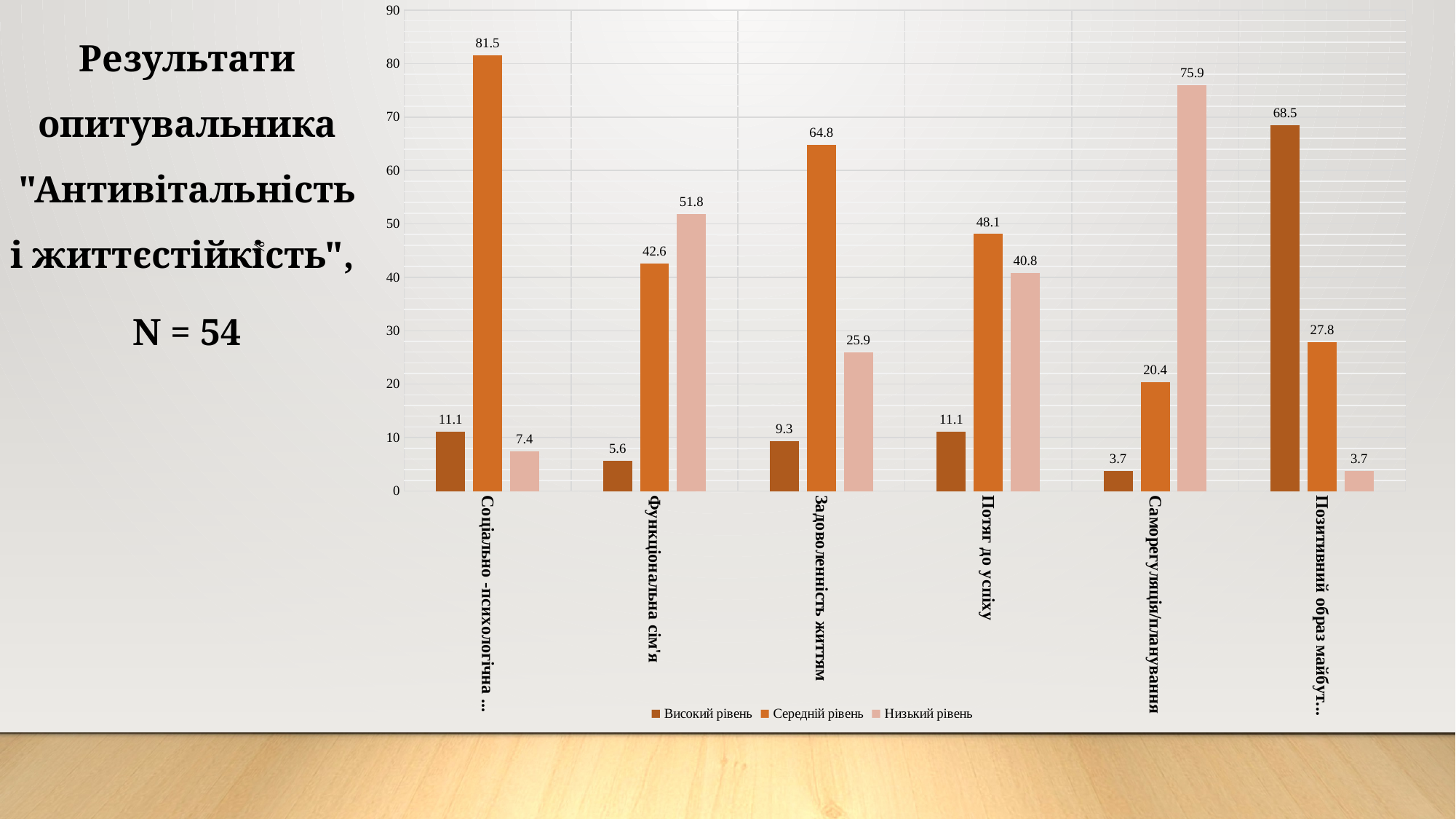
What is the difference between Середній рівень and Низький рівень for Задоволеність життям? 38.9 What are the three legend entries of the chart? Високий рівень, Середній рівень, Низький рівень What is the value of Середній рівень for Задоволеність життям? 64.8 How many series does the legend list? 3 What is the value of Низький рівень for Саморегуляція/планування? 75.9 What type of chart is shown on the slide? bar chart What is the value of Низький рівень for Потяг до успіху? 40.8 Which series has the highest value for Функціональна сім'я? Низький рівень Which series has the lowest value for Саморегуляція/планування? Високий рівень What is the value of Високий рівень for Функціональна сім'я? 5.6 Which is larger for Потяг до успіху: Середній рівень or Низький рівень? Середній рівень How many categories are shown on the x axis? 6